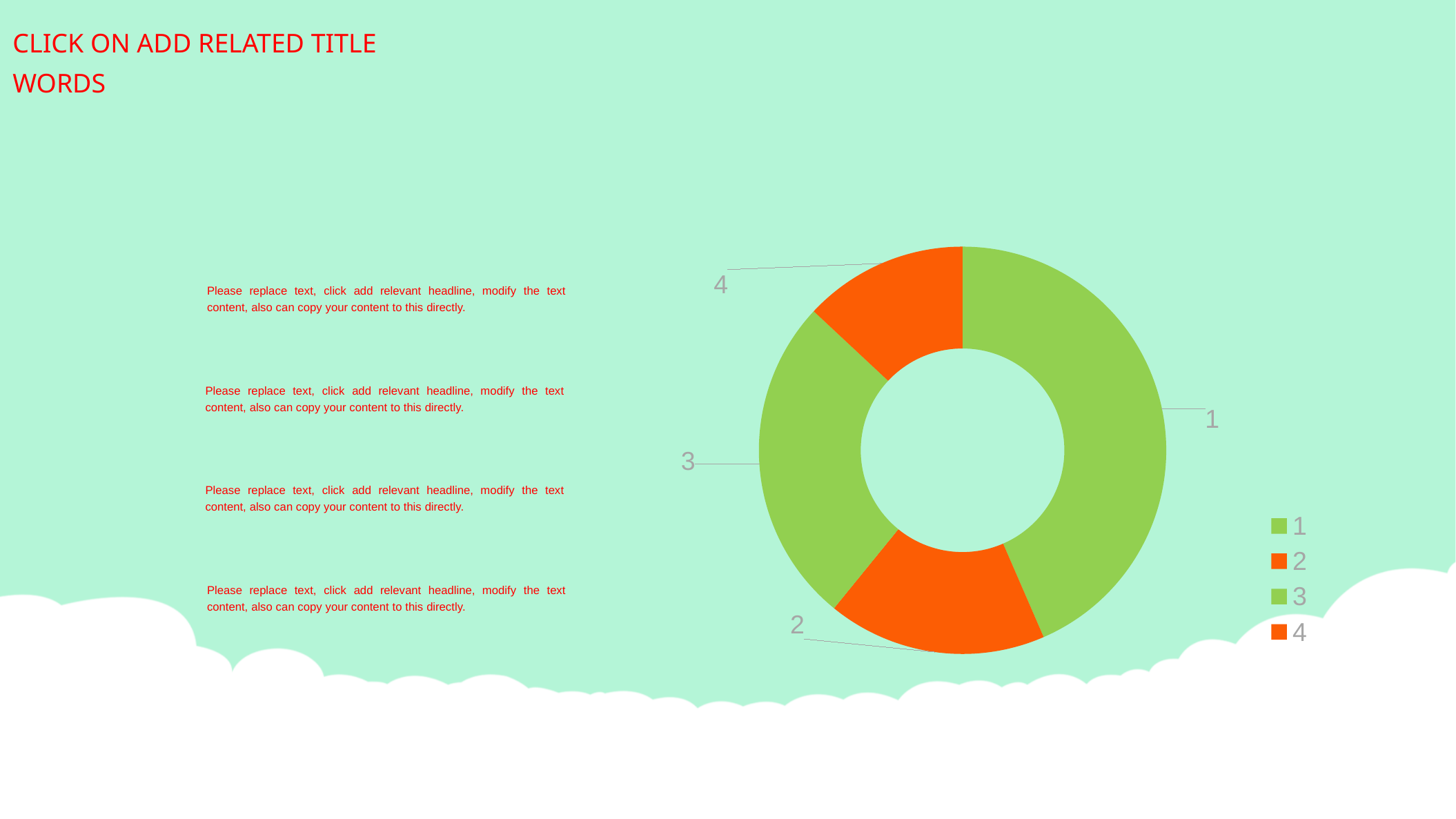
What colour is slice 2 in the doughnut chart? Orange Which slice of the doughnut chart is the largest? 1 What kind of chart is shown on the slide? Doughnut chart Which slice is larger, 1 or 3? 1 Which slice is larger, 1 or 4? 1 Which slice is larger, 2 or 4? 2 Which slice of the doughnut chart is the smallest? 4 How many entries does the chart legend list? 4 How many slices does the doughnut chart have? 4 What are the labels listed in the chart legend? 1, 2, 3, 4